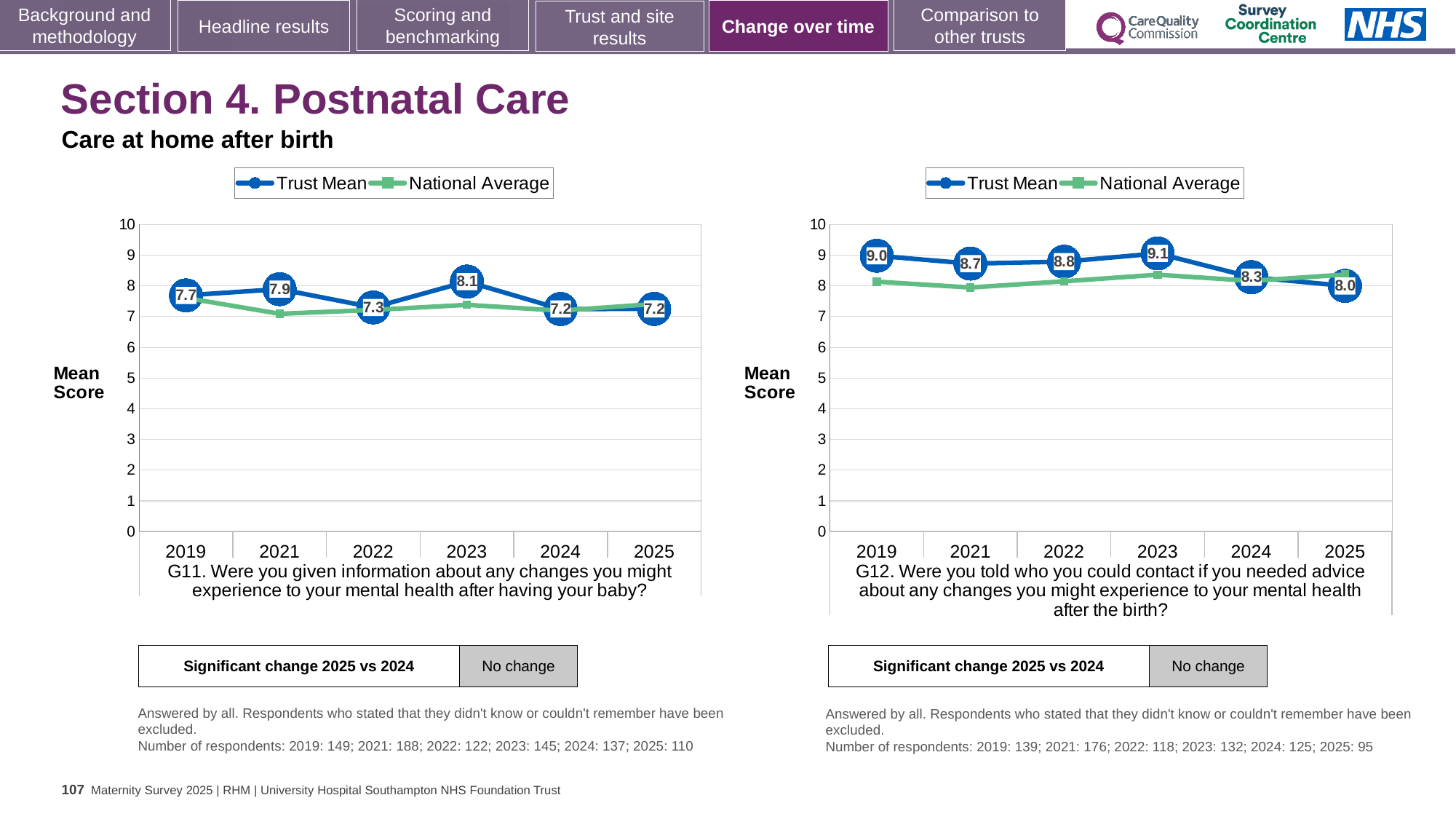
In the G12 chart on the right, which year has the lowest Trust Mean score? 2025 What kind of chart is the G11 chart on the left? Line chart In the G12 chart on the right, which year has the highest Trust Mean score? 2023 In the G11 chart on the left, which year has the highest Trust Mean score? 2023 In the G12 chart on the right, what is the Trust Mean score for 2019? 9.0 In the G12 chart on the right, is the National Average value for 2021 greater or less than 9? less In the G11 chart on the left, what is the difference between the Trust Mean scores for 2023 and 2022? 0.8 In the G12 chart on the right, is the Trust Mean score for 2021 or 2024 larger? 2021 How many series does the legend of the G12 chart on the right list? 2 In the G11 chart on the left, what is the Trust Mean score for 2025? 7.2 In the G11 chart on the left, what is the Trust Mean score for 2023? 8.1 In the G11 chart on the left, how many years are shown on the x axis? 6